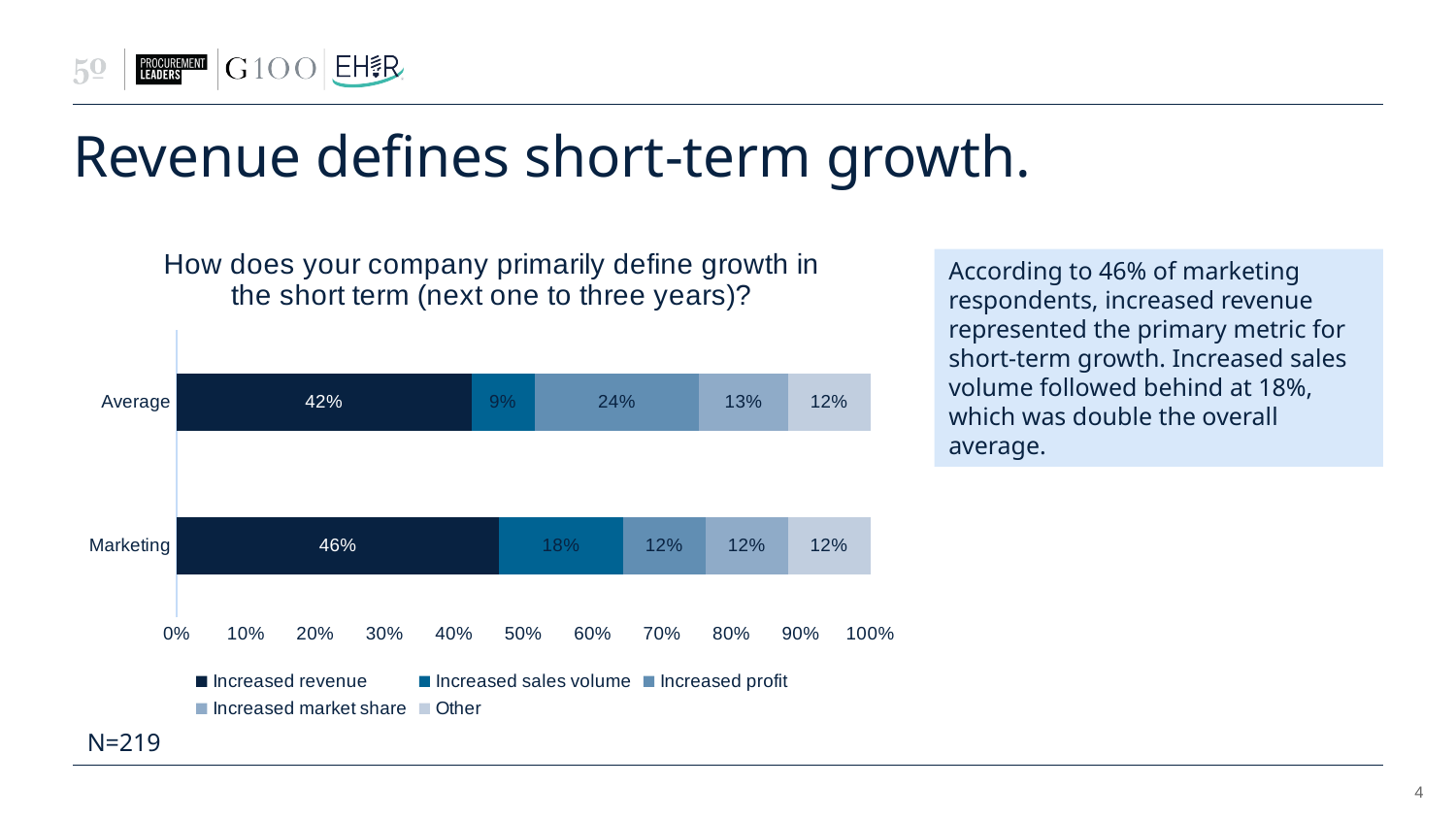
How many series does the legend list? 5 Which category has the higher value for Increased revenue, Average or Marketing? Marketing What is the difference between the Marketing and Average values for Increased sales volume? 9% What is the Average value for Increased sales volume? 9% How many categories are shown on the chart? 2 What is the Marketing value for Increased sales volume? 18% Which series has the smallest share in the Average bar? Increased sales volume What is the Average value for Increased profit? 24% What percentage of Marketing respondents chose Increased revenue? 46% What is the difference between the Marketing and Average values for Increased profit? 12% What kind of chart is shown on the slide? Stacked bar chart Which series has the largest share in the Average bar? Increased revenue